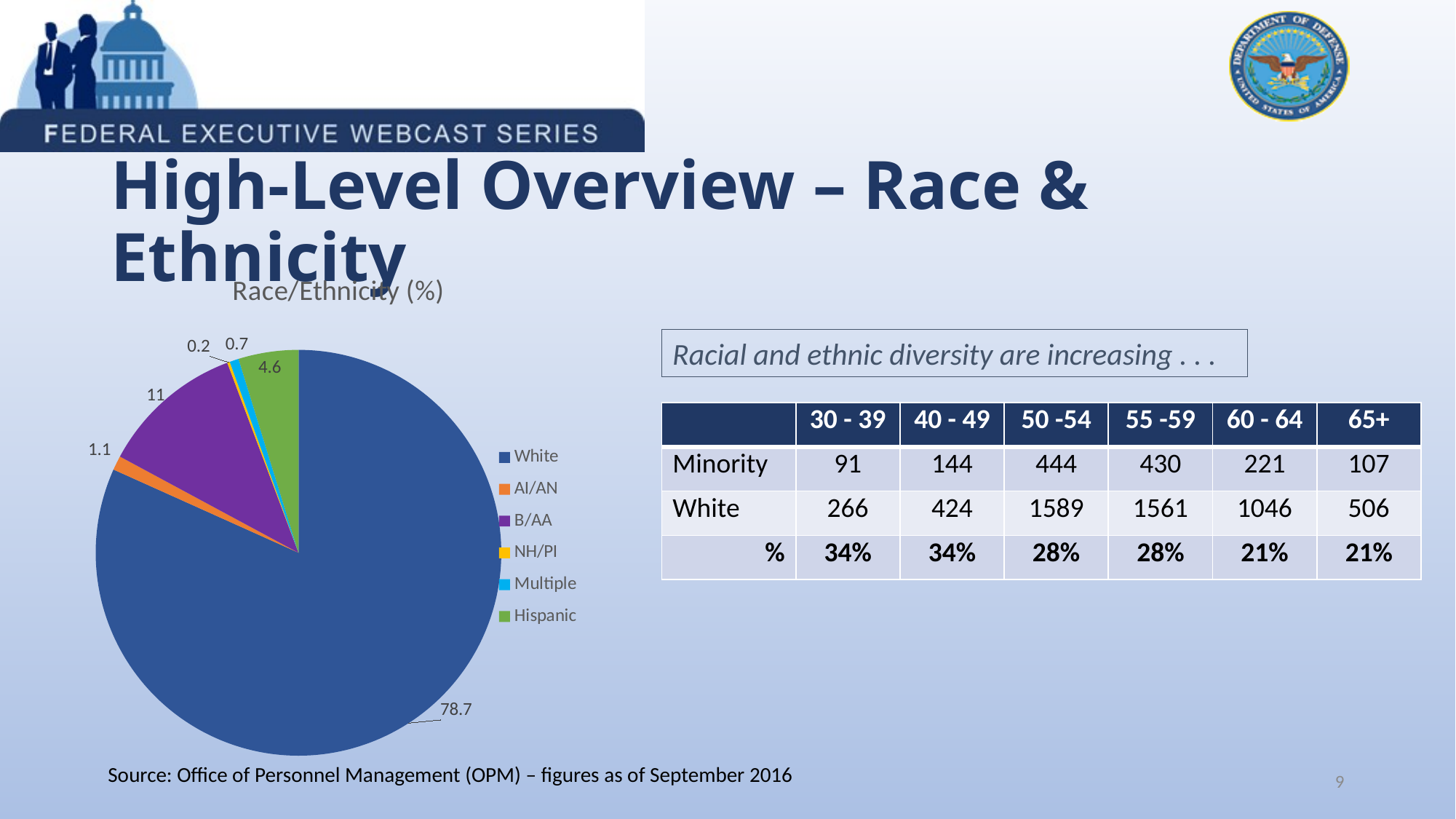
What is the value for Hispanic in the pie chart? 4.6 What is the difference between the values for B/AA and Hispanic in the pie chart? 6.4 What is the title of the pie chart? Race/Ethnicity (%) What is the value for B/AA in the pie chart? 11 What is the value for AI/AN in the pie chart? 1.1 Which is larger in the pie chart, Hispanic or AI/AN? Hispanic What kind of chart is shown on the slide? pie chart What is the value for White in the pie chart? 78.7 Which category has the smallest slice in the pie chart? NH/PI How many categories does the pie chart's legend list? 6 What is the value for NH/PI in the pie chart? 0.2 Which category has the largest slice in the pie chart? White